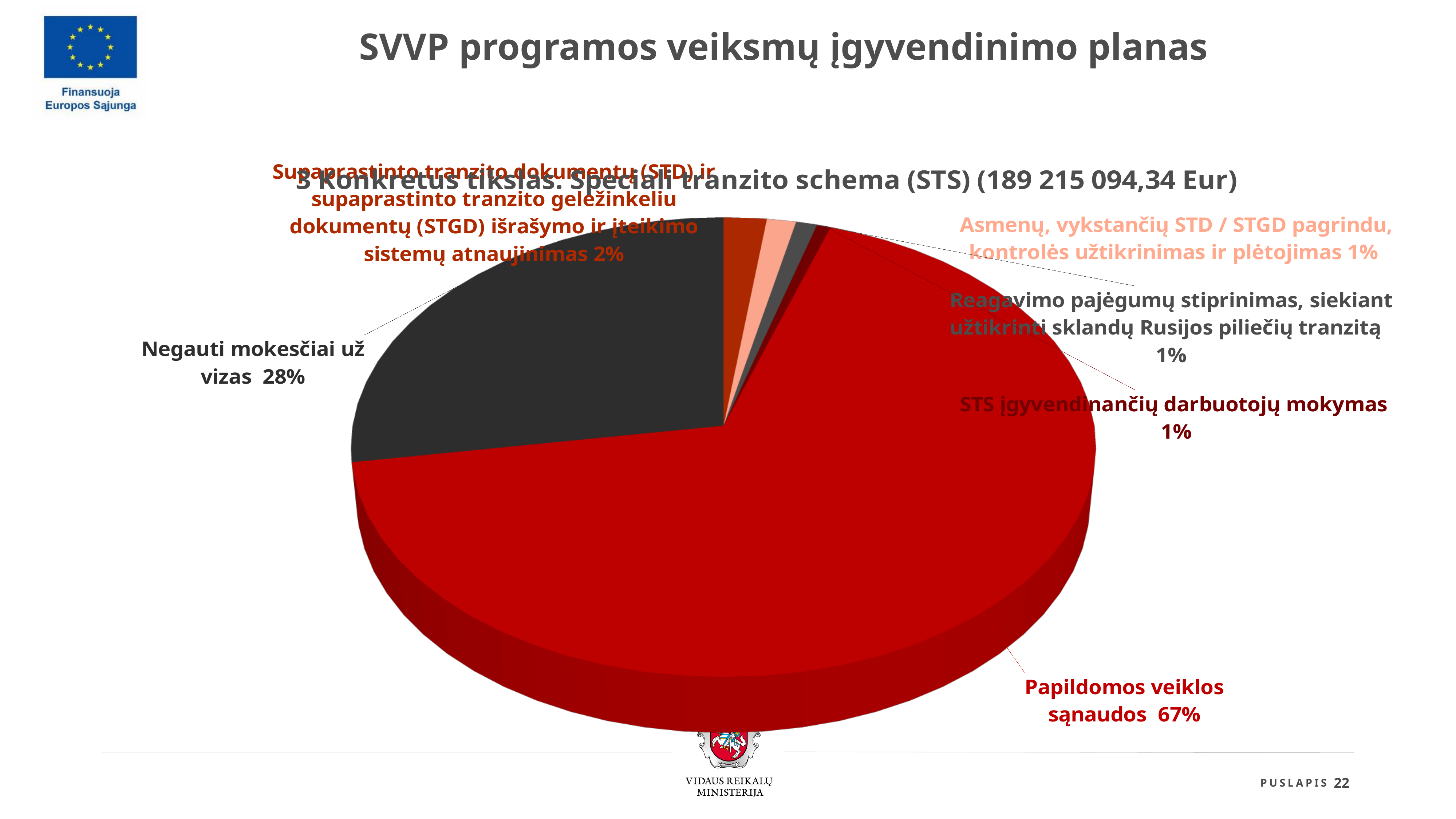
What combined share do "Papildomos veiklos sąnaudos" and "Negauti mokesčiai už vizas" make up together? 95% What total amount in Eur is stated in the chart title for the Speciali tranzito schema (STS)? 189 215 094,34 Eur What percentage is shown for the slice about updating the STD and STGD issuing and delivery systems ("sistemų atnaujinimas")? 2% Which slice of the pie is the largest? Papildomos veiklos sąnaudos What percentage is shown for "STS įgyvendinančių darbuotojų mokymas"? 1% What kind of chart is shown on the slide? Pie chart What share of the pie does "Papildomos veiklos sąnaudos" represent? 67% Which is larger: the share for "Negauti mokesčiai už vizas" or the share for the STD/STGD systems update ("sistemų atnaujinimas")? Negauti mokesčiai už vizas What percentage is shown for "Negauti mokesčiai už vizas"? 28% What percentage is shown for "Reagavimo pajėgumų stiprinimas, siekiant užtikrinti sklandų Rusijos piliečių tranzitą"? 1% How many slices does the pie chart have? 6 What is the difference in percentage points between "Papildomos veiklos sąnaudos" and "Negauti mokesčiai už vizas"? 39 percentage points